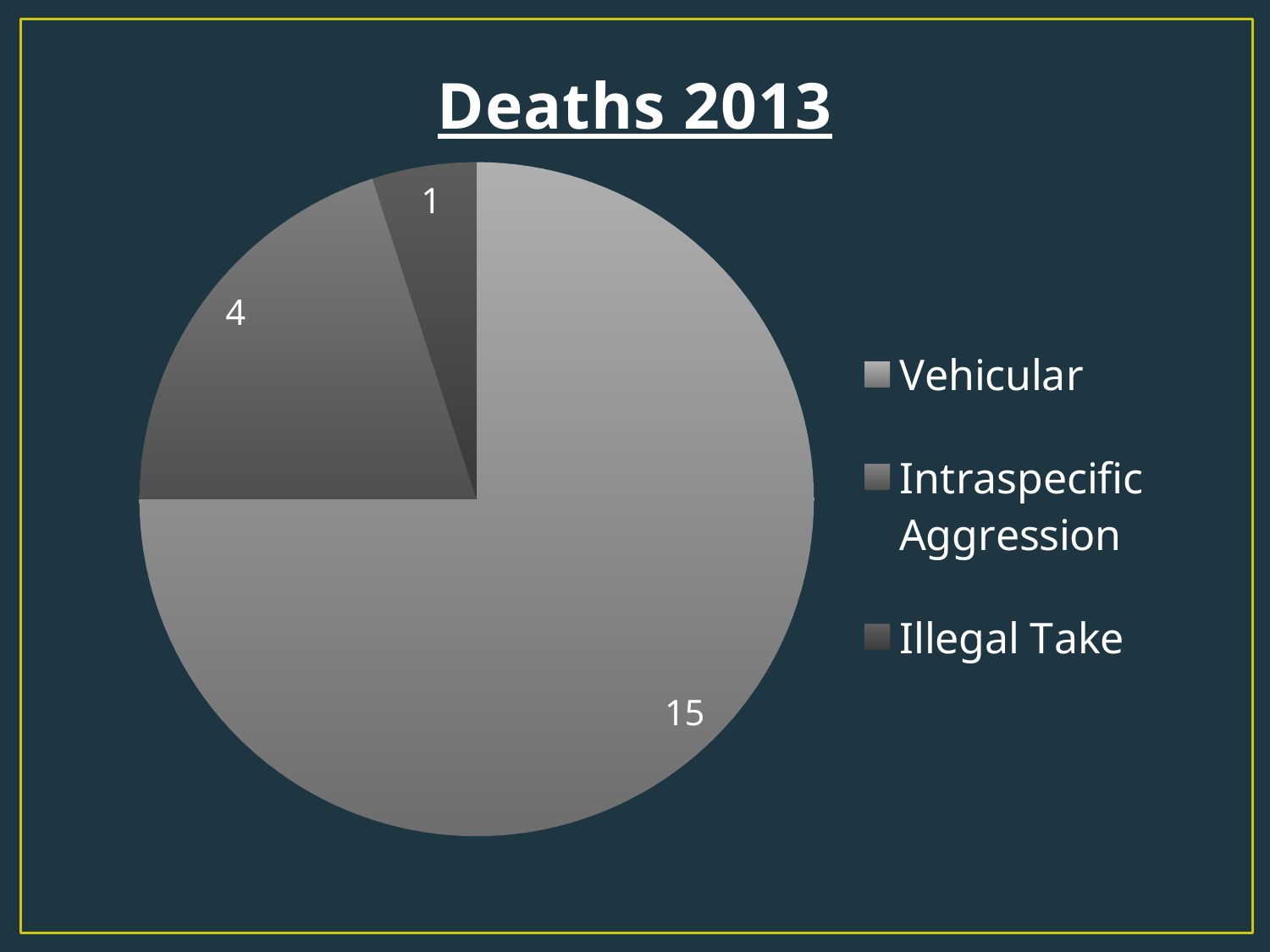
What type of chart is shown on the slide? pie chart What is the value for Vehicular? 15 What is the difference between the Vehicular and Intraspecific Aggression values? 11 What share of the pie does Vehicular represent? 75% What is the title of the chart? Deaths 2013 What is the value for Illegal Take? 1 Which is larger, Intraspecific Aggression or Illegal Take? Intraspecific Aggression What is the total of all slices in the pie chart? 20 Which category has the largest slice? Vehicular Which category has the smallest slice? Illegal Take What is the value for Intraspecific Aggression? 4 How many categories does the pie chart have? 3